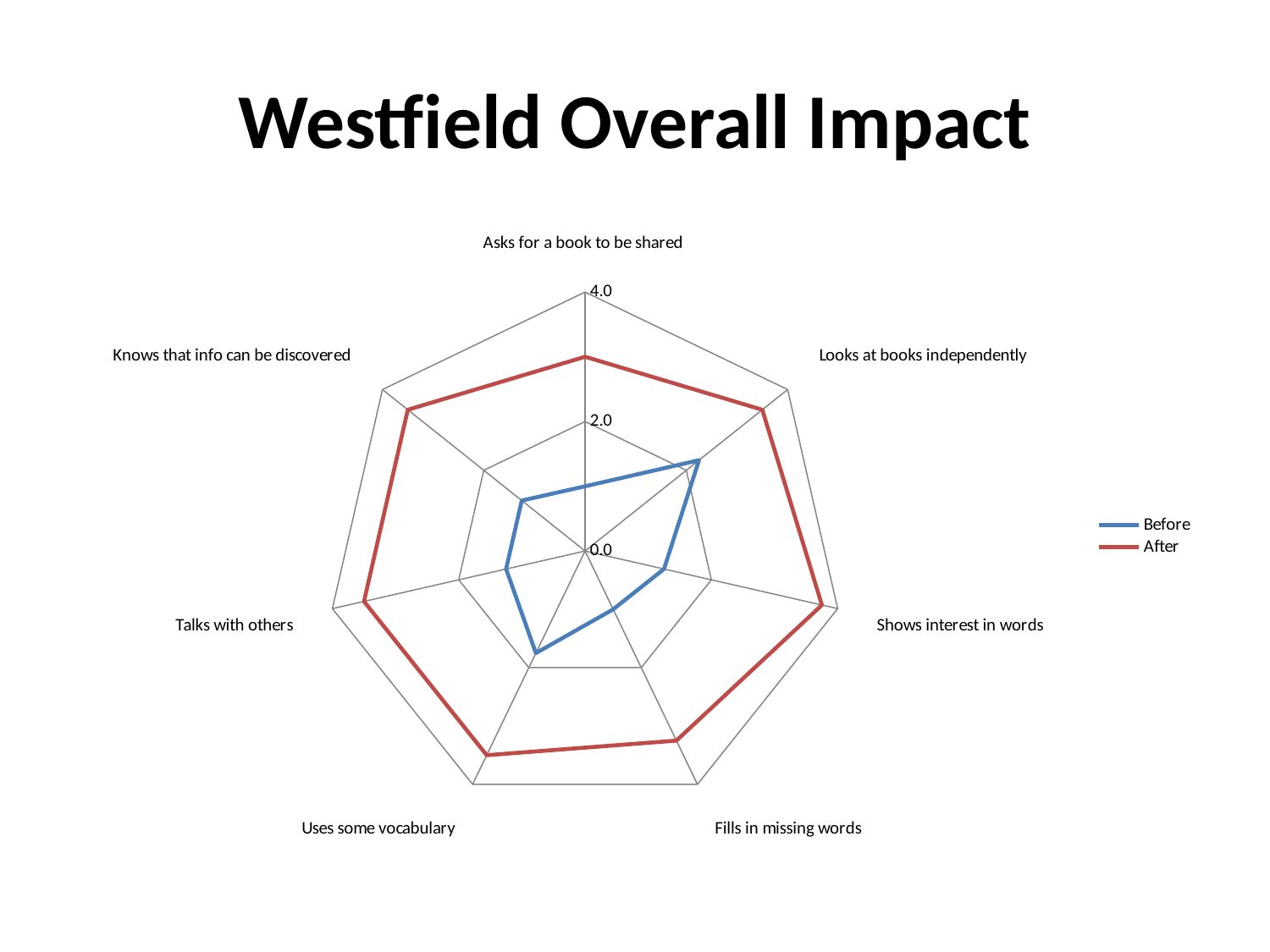
How many categories (axes) does the radar chart have? 7 For which category is the Before value highest? Looks at books independently Is the After value for Uses some vocabulary greater or less than 2.0? greater Is the Before value for Looks at books independently greater or less than 2.0? greater What colour is the line for the After series? Red What kind of chart is shown on the slide? Radar chart How many series does the legend list? 2 For Talks with others, which series has the larger value, Before or After? After Is the Before value for Fills in missing words greater or less than 2.0? less What are the two series named in the legend? Before and After For Asks for a book to be shared, which series has the larger value, Before or After? After